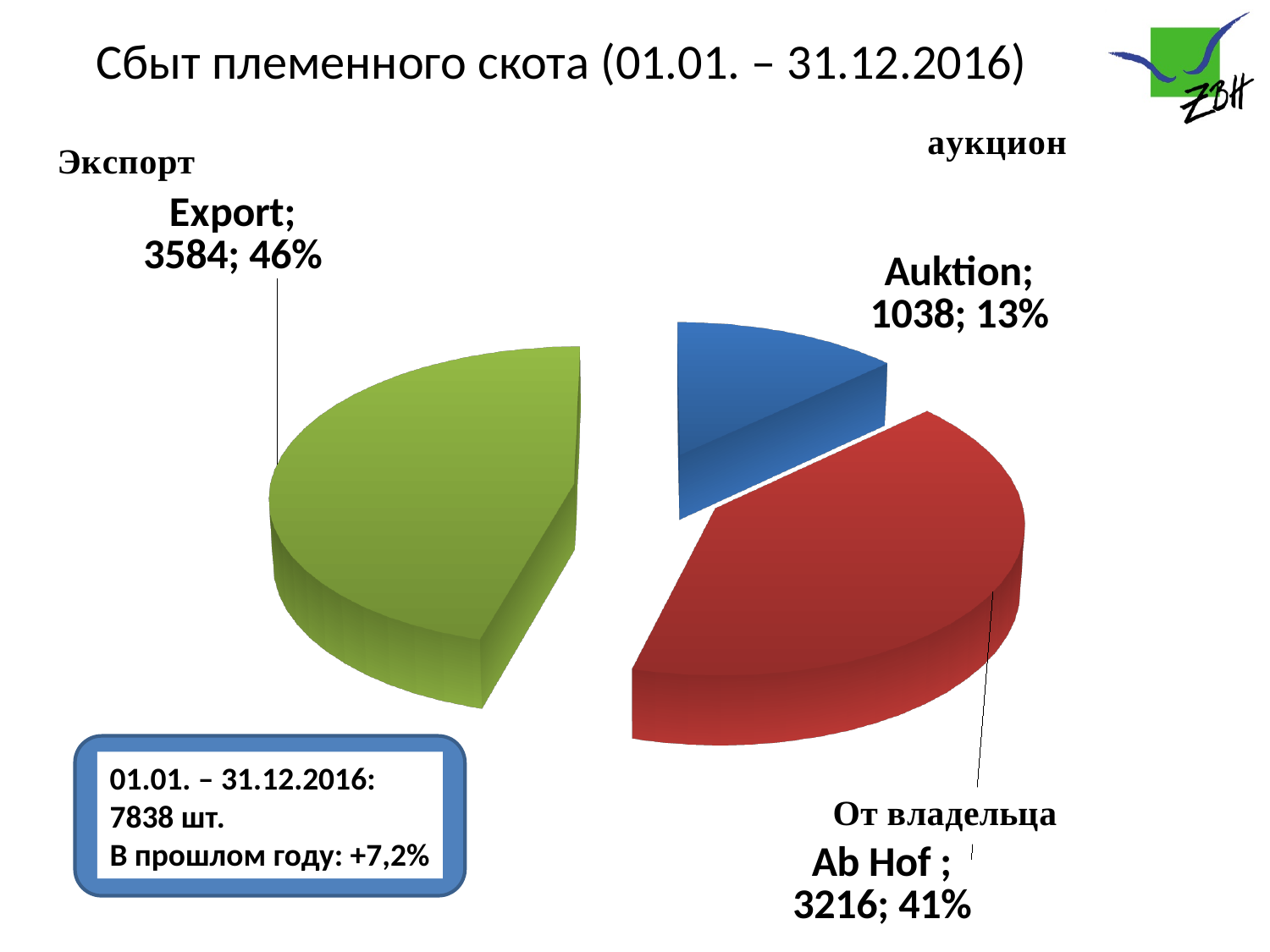
What kind of chart is shown on the slide? pie chart What share of the pie does Auktion represent? 13% How many slices does the pie chart have? 3 What is the value for Export? 3584 Which slice is the smallest? Auktion What share of the pie does Ab Hof represent? 41% Which slice is the largest? Export Which is larger, Ab Hof or Auktion? Ab Hof What is the value for Ab Hof? 3216 What share of the pie does Export represent? 46% What is the value for Auktion? 1038 What is the difference between the Export value and the Ab Hof value? 368